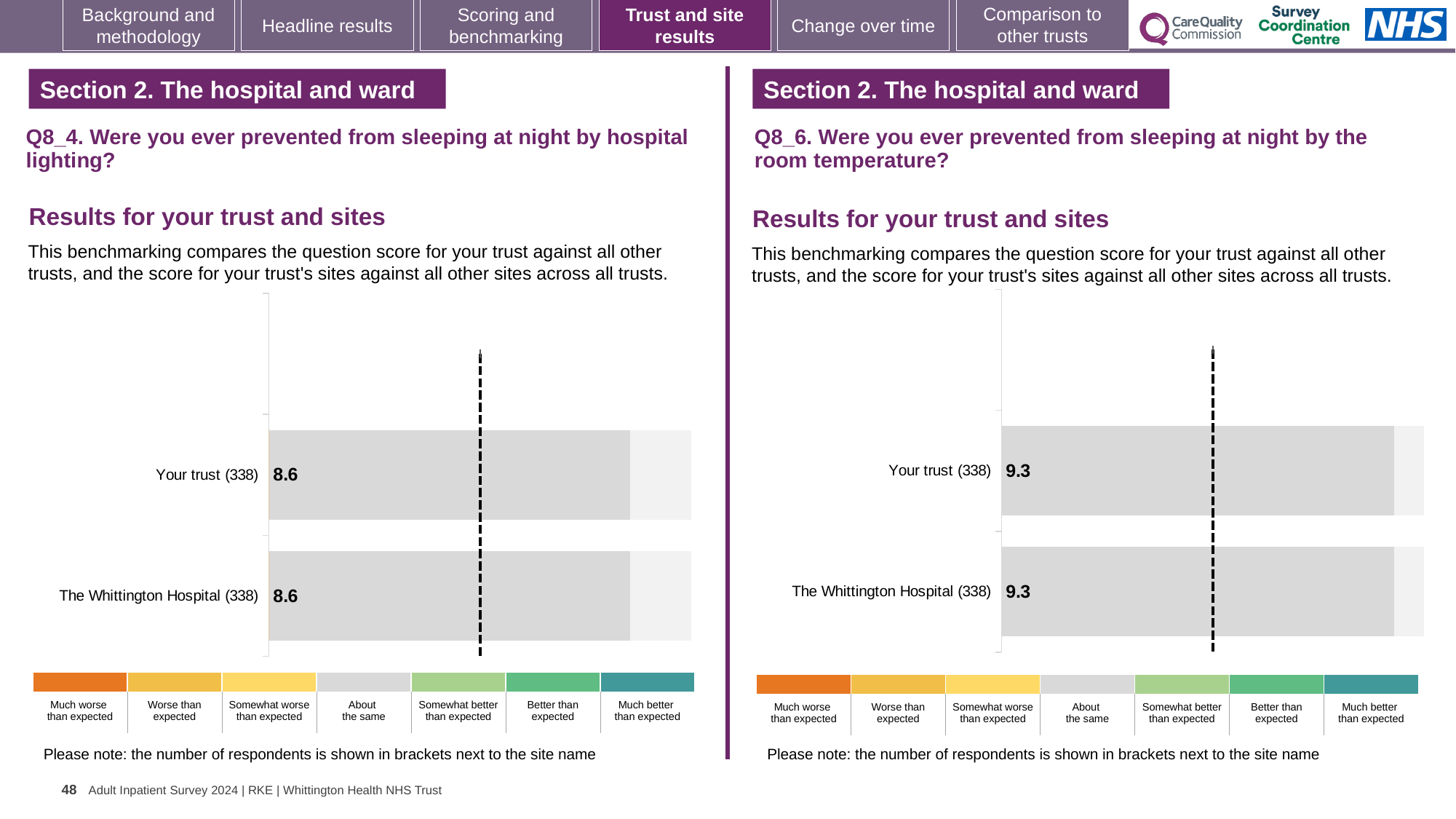
On the Q8_4 chart (hospital lighting), what is the score for Your trust (338)? 8.6 On the Q8_4 chart (hospital lighting), how many respondents are shown in brackets next to Your trust? 338 How many categories does the colour legend below the Q8_4 chart (hospital lighting) list? 7 On the Q8_4 chart (hospital lighting), what is the difference between the score for Your trust and the score for The Whittington Hospital? 0 How many bars are plotted on the Q8_4 chart (hospital lighting)? 2 On the Q8_6 chart (room temperature), what is the score for Your trust (338)? 9.3 On the Q8_6 chart (room temperature), what is the score for The Whittington Hospital (338)? 9.3 How many bars are plotted on the Q8_6 chart (room temperature)? 2 On the Q8_6 chart (room temperature), what is the difference between the score for Your trust and the score for The Whittington Hospital? 0 On the Q8_6 chart (room temperature), which benchmark category does the grey colour of the bars correspond to in the legend? About the same What kind of chart is used on the Q8_4 chart (hospital lighting)? Bar chart On the Q8_4 chart (hospital lighting), what is the score for The Whittington Hospital (338)? 8.6